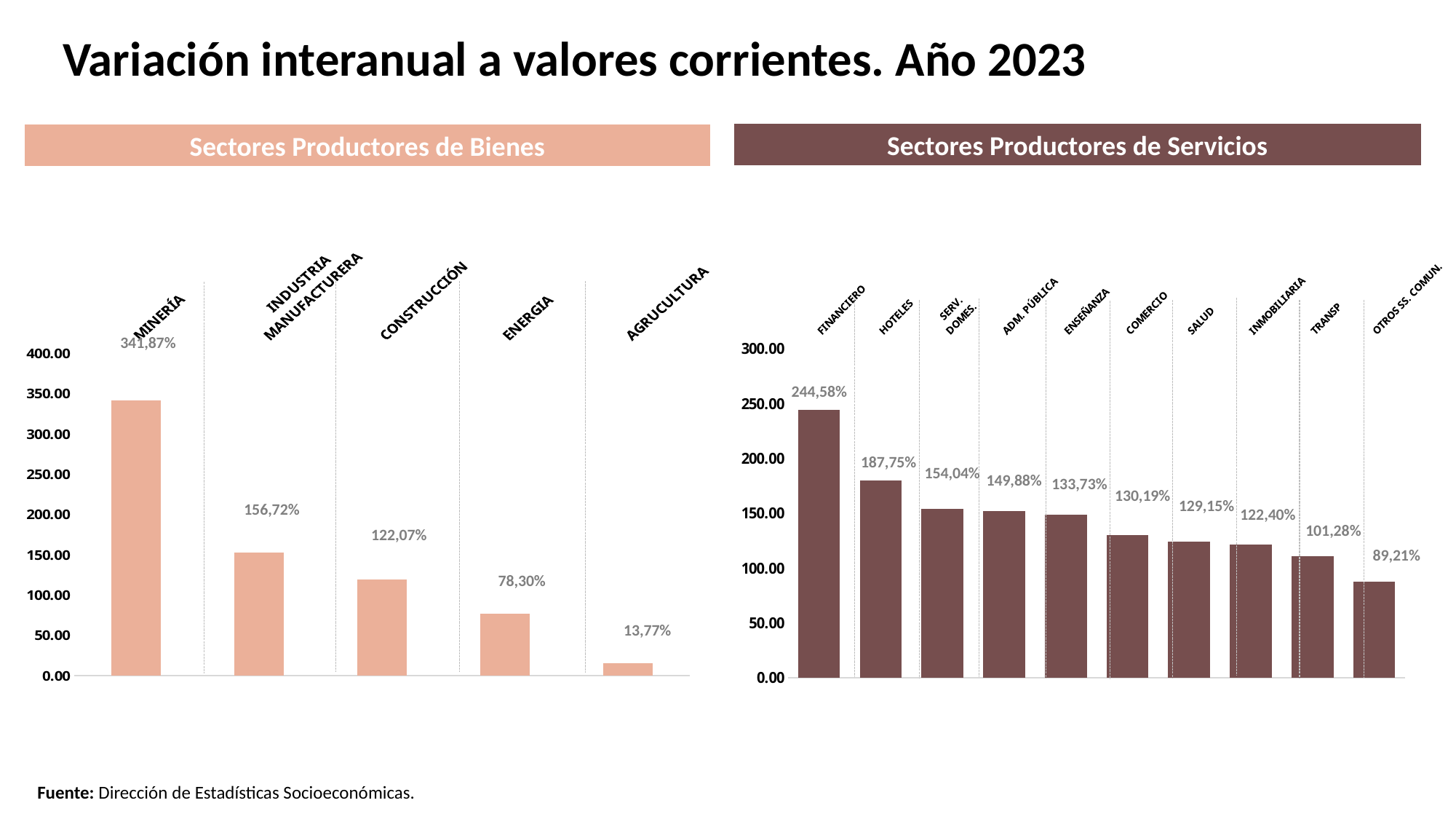
In the 'Sectores Productores de Servicios' chart, which is larger: HOTELES or SERV. DOMES.? HOTELES In the 'Sectores Productores de Servicios' chart, how many sectors are shown? 10 In the 'Sectores Productores de Bienes' chart, what is the value for MINERÍA? 341,87% In the 'Sectores Productores de Servicios' chart, what is the difference between FINANCIERO and OTROS SS. COMUN.? 155,37 What type of chart is used on the slide? bar chart In the 'Sectores Productores de Servicios' chart, what is the value for COMERCIO? 130,19% In the 'Sectores Productores de Servicios' chart, do the values rise or fall from left to right? fall In the 'Sectores Productores de Bienes' chart, how many sectors are shown? 5 In the 'Sectores Productores de Bienes' chart, what is the difference between INDUSTRIA MANUFACTURERA and CONSTRUCCIÓN? 34,65 In the 'Sectores Productores de Bienes' chart, what is the value for ENERGIA? 78,30% In the 'Sectores Productores de Bienes' chart, which sector has the lowest value? AGRUCULTURA In the 'Sectores Productores de Servicios' chart, which sector has the highest value? FINANCIERO